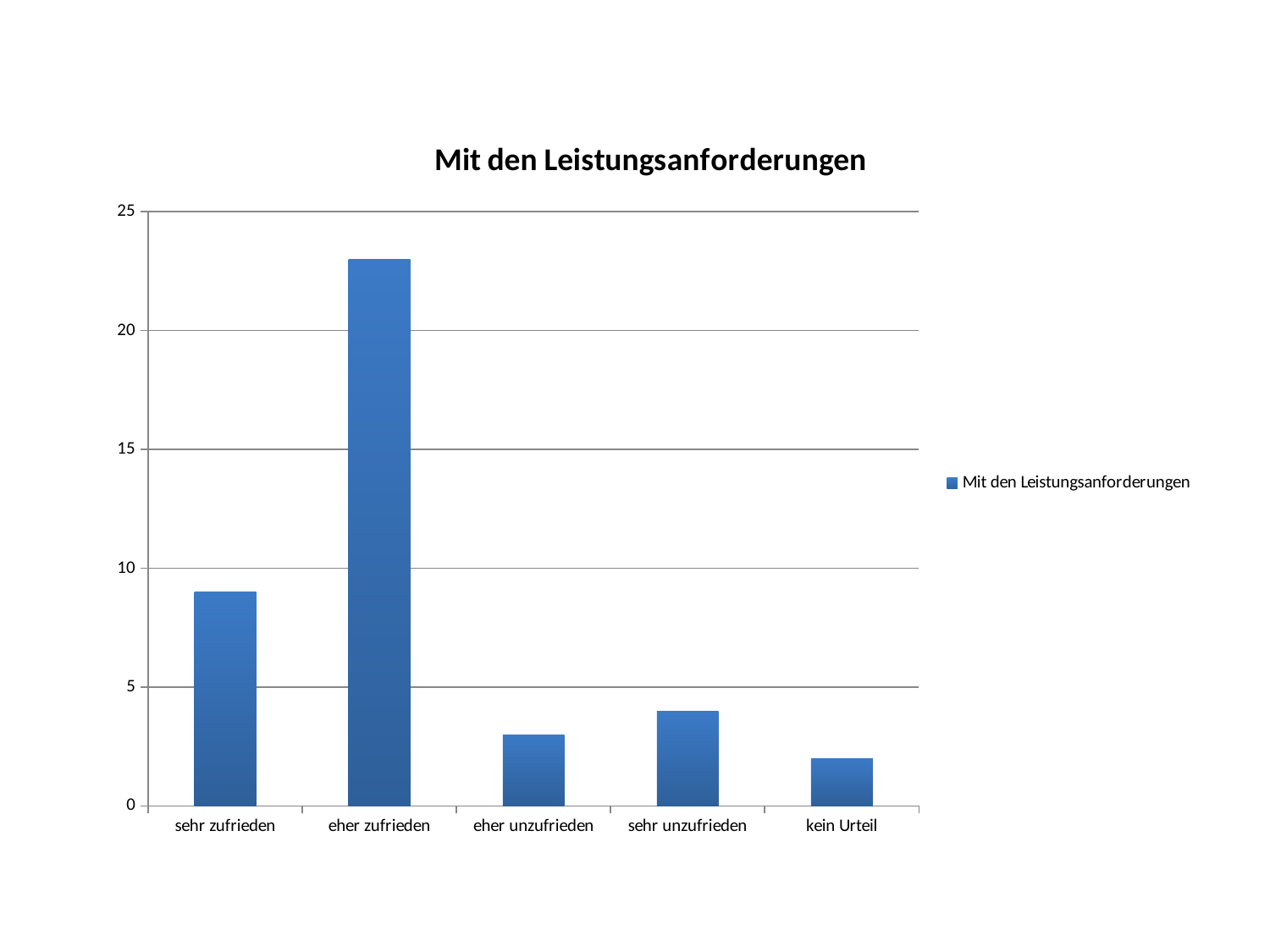
Which category has the highest value? eher zufrieden How many categories are shown on the x axis? 5 Which category has the lowest value? kein Urteil What is the title of the chart? Mit den Leistungsanforderungen How many series does the legend list? 1 Is the value for sehr zufrieden greater or less than 5? greater Is the value for eher zufrieden greater or less than 20? greater Is the value for sehr zufrieden greater or less than 10? less Which is larger, the value for sehr zufrieden or the value for sehr unzufrieden? sehr zufrieden Which is larger, the value for eher zufrieden or the value for kein Urteil? eher zufrieden What kind of chart is shown on the slide? bar chart